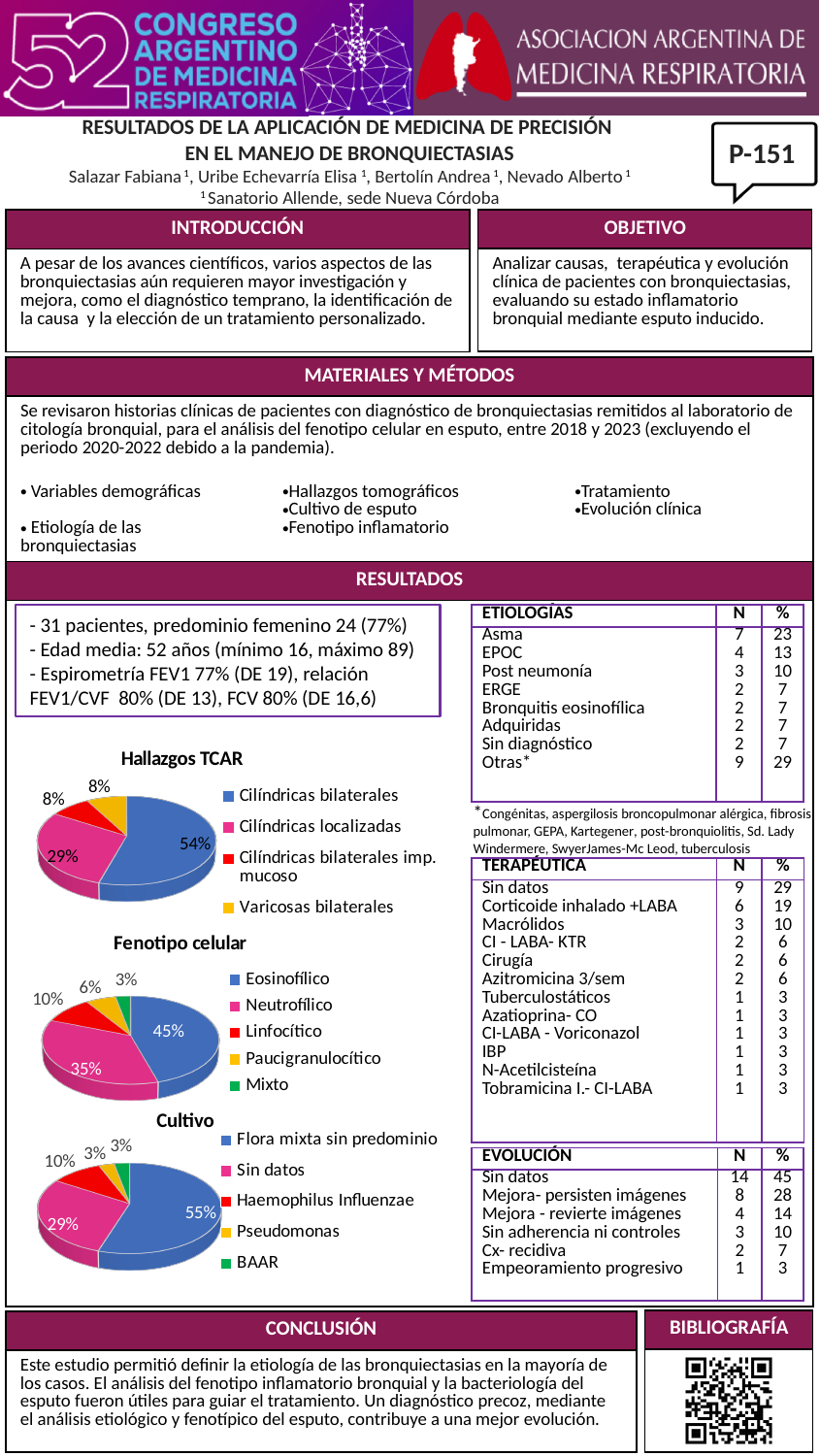
In the 'Fenotipo celular' pie chart, which category has the smallest slice? Mixto In the 'Hallazgos TCAR' pie chart, which category has the largest slice? Cilíndricas bilaterales In the 'Fenotipo celular' pie chart, what share is labelled for Eosinofílico? 45% How many categories does the 'Fenotipo celular' pie chart show? 5 In the 'Fenotipo celular' pie chart, what is the difference between the Eosinofílico and Neutrofílico shares? 10% In the 'Cultivo' pie chart, which is larger: Sin datos or Haemophilus Influenzae? Sin datos In the 'Hallazgos TCAR' pie chart, what share is labelled for Cilíndricas bilaterales? 54% What type of chart is used for 'Cultivo'? Pie chart In the 'Fenotipo celular' pie chart, what share is labelled for Neutrofílico? 35% How many entries does the legend of the 'Hallazgos TCAR' chart list? 4